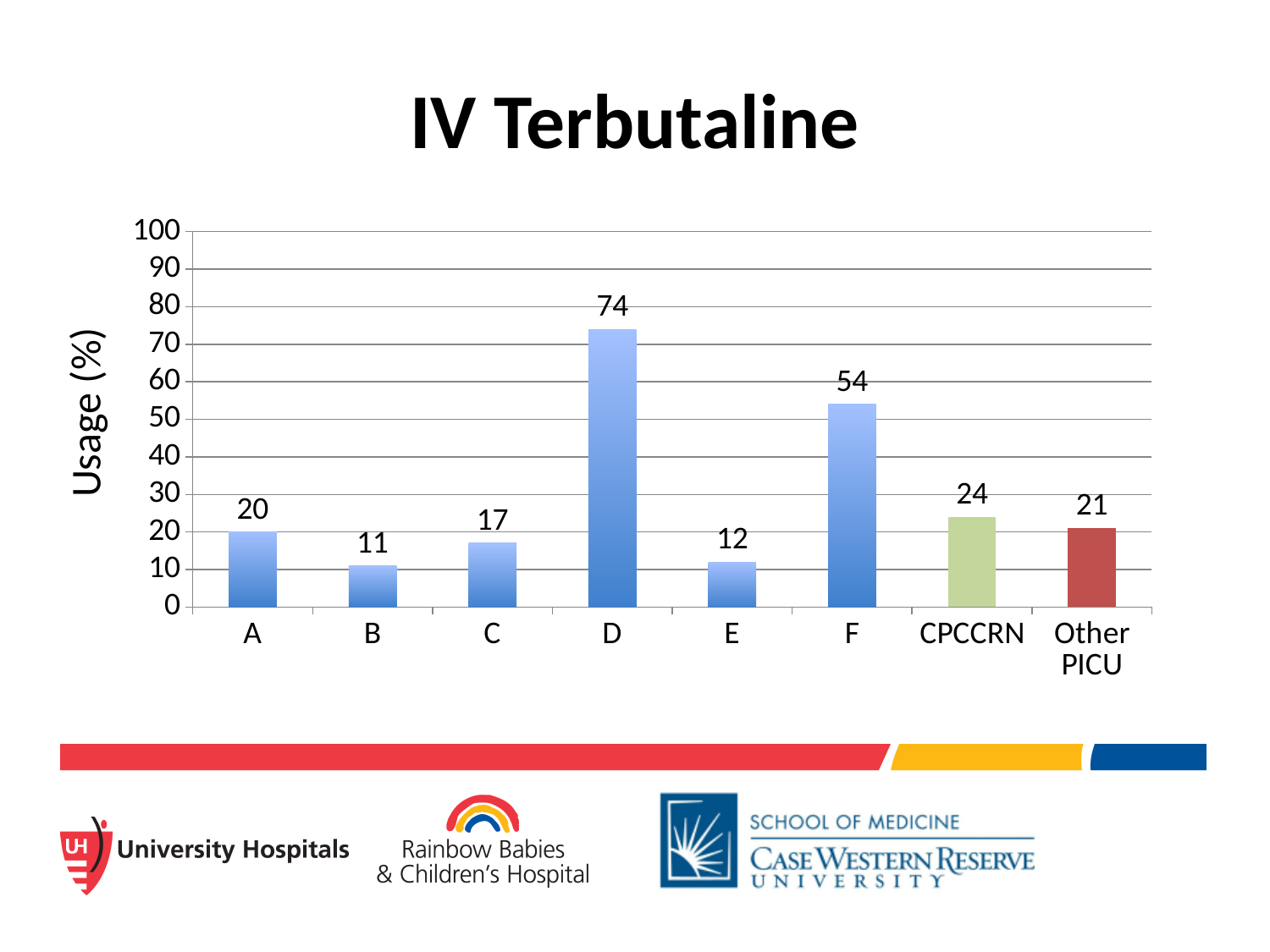
What kind of chart is shown on the slide? Bar chart What is the usage (%) for CPCCRN? 24 Is the usage for site F greater or less than 50? greater What is the usage (%) for site D? 74 What is the title of the chart? IV Terbutaline What is the usage (%) for Other PICU? 21 Which has higher usage, site A or site C? A Which category has the lowest usage? B Which category has the highest usage? D How many categories are shown on the x axis? 8 What is the difference in usage between site D and site F? 20 What is the difference in usage between CPCCRN and Other PICU? 3